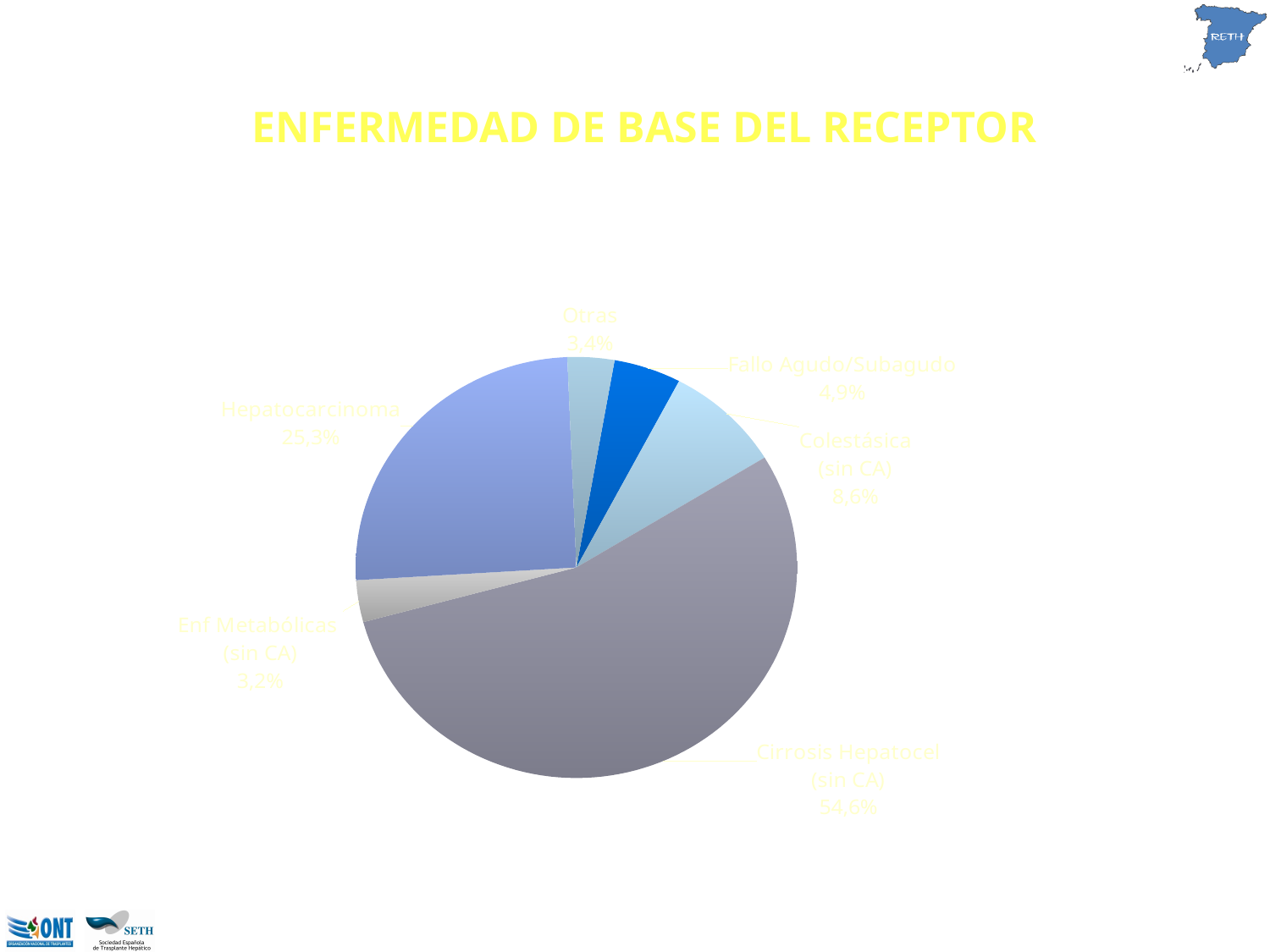
What share of the pie is Hepatocarcinoma? 25,3% Which is larger, the slice for Otras or the slice for Colestásica (sin CA)? Colestásica (sin CA) What is the value shown for Enf Metabólicas (sin CA)? 3,2% What is the difference in percentage points between Cirrosis Hepatocel (sin CA) and Hepatocarcinoma? 29,3 Which category has the smallest slice of the pie? Enf Metabólicas (sin CA) What is the value shown for Fallo Agudo/Subagudo? 4,9% What is the value shown for Colestásica (sin CA)? 8,6% What kind of chart is shown on the slide? pie chart How many slices does the pie chart have? 6 Which category has the largest slice of the pie? Cirrosis Hepatocel (sin CA) What is the title of the chart? ENFERMEDAD DE BASE DEL RECEPTOR What share of the pie is Cirrosis Hepatocel (sin CA)? 54,6%